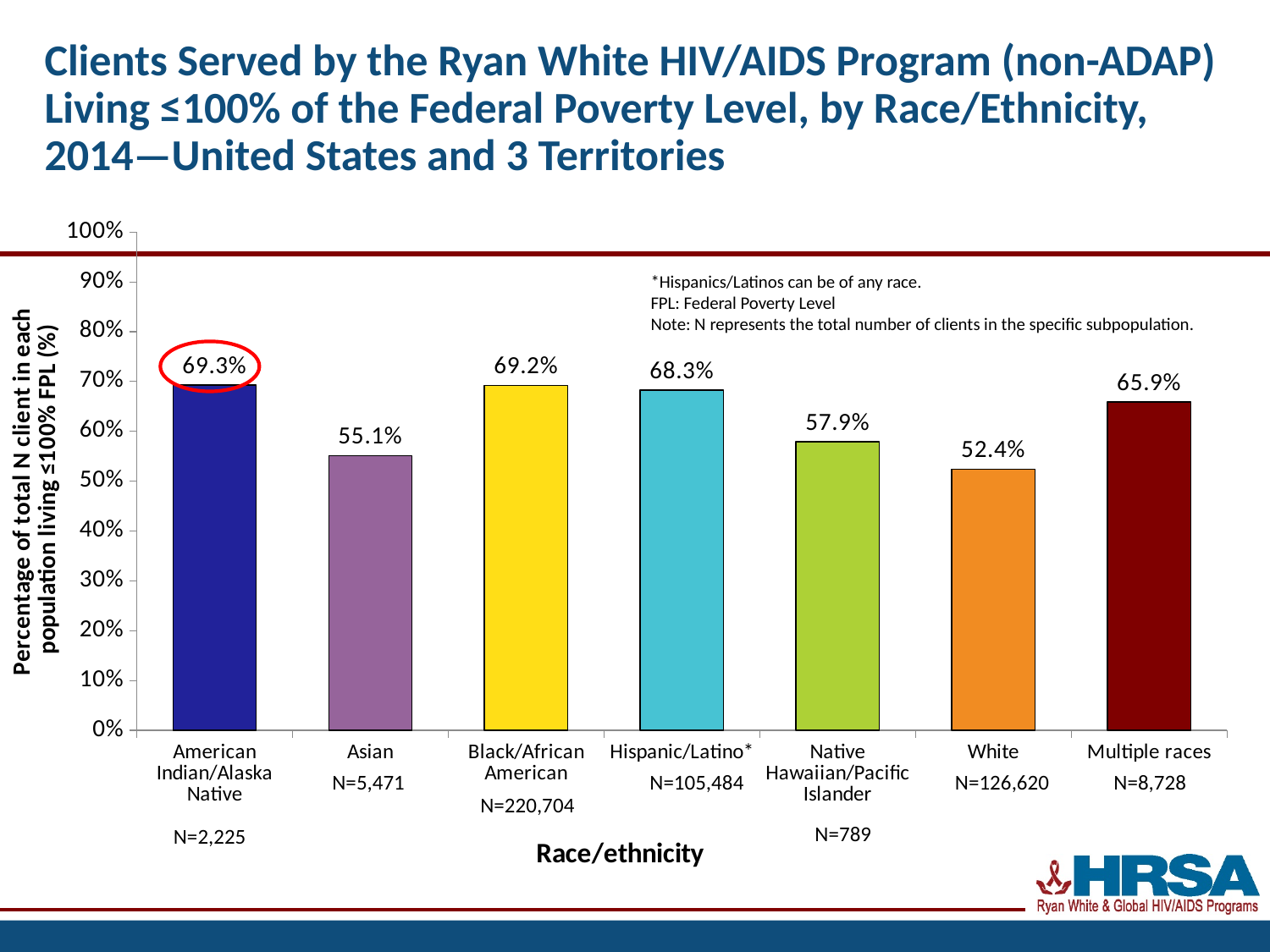
Which is larger, the value for Native Hawaiian/Pacific Islander or the value for Asian? Native Hawaiian/Pacific Islander What is the value shown for White clients? 52.4% How many race/ethnicity categories are shown in the chart? 7 Which race/ethnicity category has the lowest percentage living ≤100% FPL? White What is the N (total number of clients) shown for the Black/African American category? N=220,704 Is the value for Multiple races greater or less than 60%? greater What is the value for the Multiple races category? 65.9% What percentage of Asian clients are living at or below 100% of the Federal Poverty Level? 55.1% What kind of chart is shown on the slide? Bar chart Which race/ethnicity category has the highest percentage living ≤100% FPL? American Indian/Alaska Native What is the difference between the percentages for Black/African American and White clients? 16.8 percentage points What percentage is shown for the Hispanic/Latino* category? 68.3%